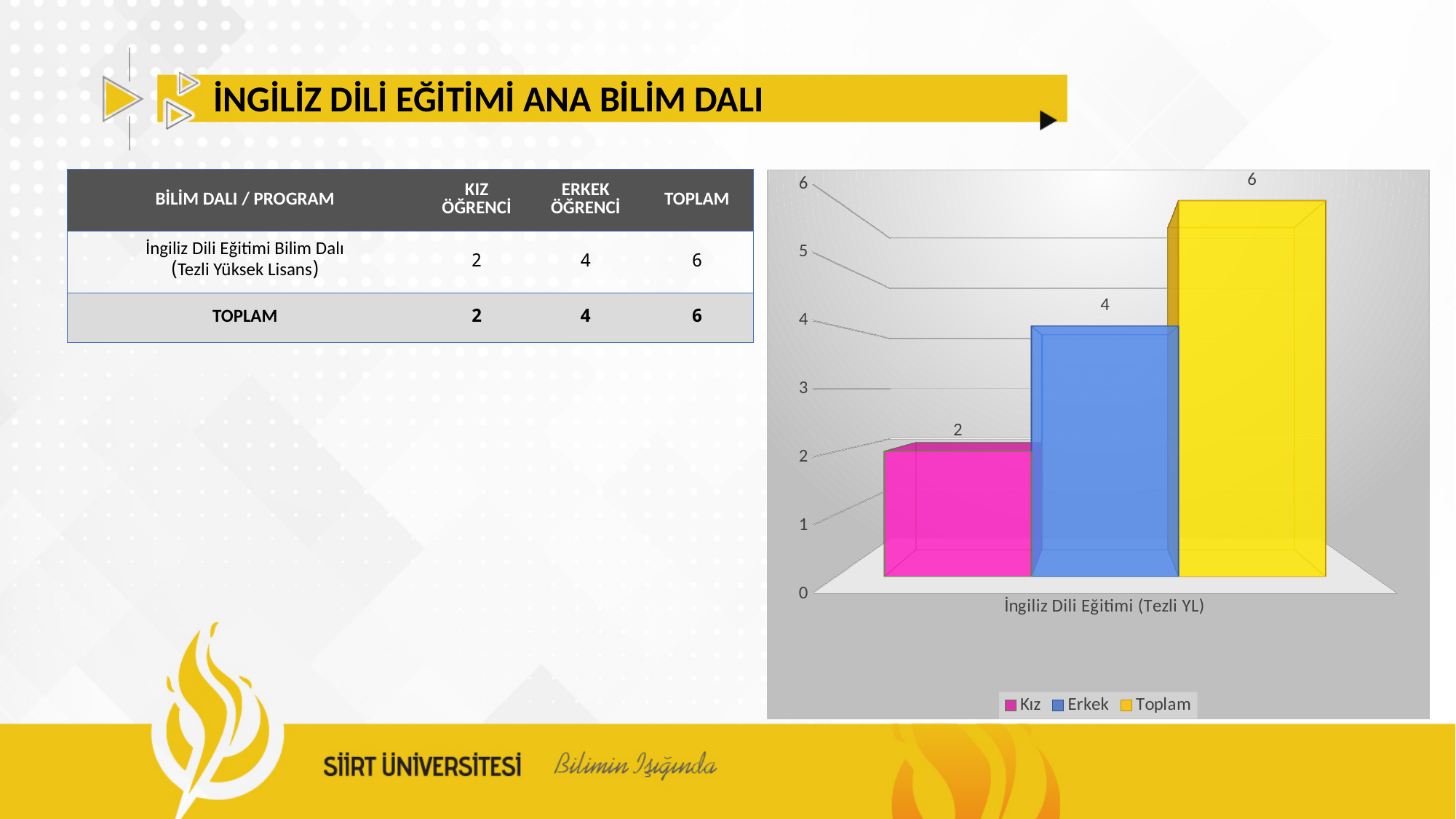
What is the value of the Kız series for İngiliz Dili Eğitimi (Tezli YL) in the chart? 2 What kind of chart is shown on the slide? bar chart Which series has the lowest value in the chart? Kız How many categories are shown on the x axis of the chart? 1 What is the value of the Toplam series for İngiliz Dili Eğitimi (Tezli YL) in the chart? 6 What colour is the Toplam series in the chart? yellow Which is larger in the chart, the Erkek value or the Kız value? Erkek How many series does the legend list in the chart? 3 Is the value for Toplam greater or less than 5? greater What is the difference between the Erkek and Kız values in the chart? 2 Which series has the highest value in the chart? Toplam What is the value of the Erkek series for İngiliz Dili Eğitimi (Tezli YL) in the chart? 4